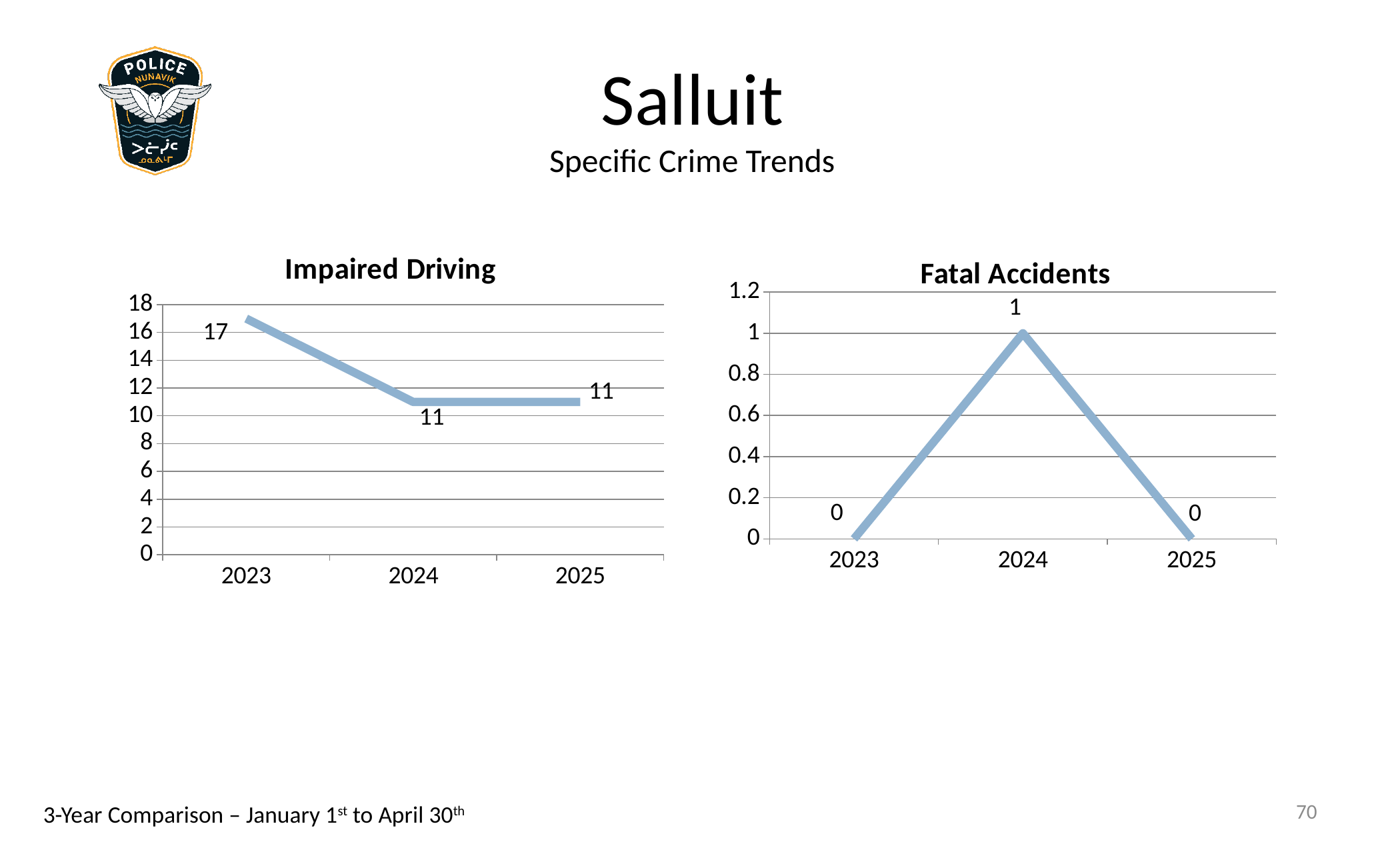
In the Fatal Accidents chart, which year has the highest value? 2024 In the Impaired Driving chart, what is the value for 2025? 11 In the Fatal Accidents chart, what is the value for 2025? 0 In the Fatal Accidents chart, is the value for 2024 larger or smaller than the value for 2023? larger In the Impaired Driving chart, what is the value for 2023? 17 In the Impaired Driving chart, do the values rise or fall from 2023 to 2024? fall How many years are plotted in the Fatal Accidents chart? 3 In the Impaired Driving chart, is the value for 2023 greater or less than 16? greater In the Impaired Driving chart, which year has the highest value? 2023 What kind of chart is the Impaired Driving chart? line chart In the Impaired Driving chart, what is the difference between the 2023 and 2024 values? 6 In the Fatal Accidents chart, what is the value for 2024? 1